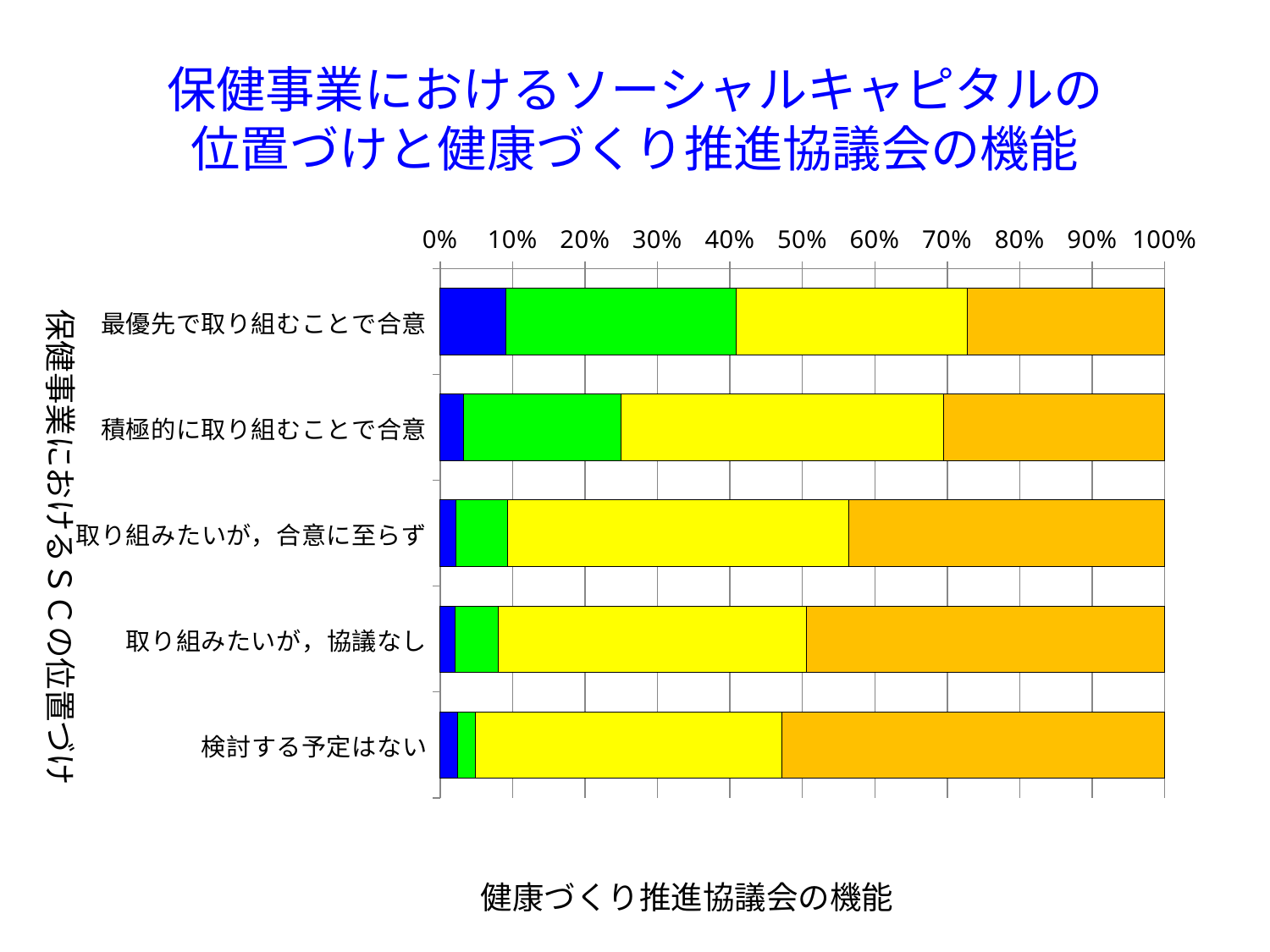
What kind of chart is shown on the slide? Stacked bar chart Does the green segment for 積極的に取り組むことで合意 end at a value greater or less than 20%? greater How many categories are plotted on the vertical axis of the chart? 5 Does the yellow segment for 検討する予定はない end at a value greater or less than 50%? less Moving down the categories from 最優先で取り組むことで合意 to 検討する予定はない, does the orange segment get larger or smaller? larger What is the title printed below the chart's horizontal axis? 健康づくり推進協議会の機能 Which category has the largest green segment? 最優先で取り組むことで合意 Which has the larger blue segment, 最優先で取り組むことで合意 or 積極的に取り組むことで合意? 最優先で取り組むことで合意 Does the yellow segment for 最優先で取り組むことで合意 end at a value greater or less than 70%? greater Which category has the largest blue segment? 最優先で取り組むことで合意 Which category has the largest orange segment? 検討する予定はない